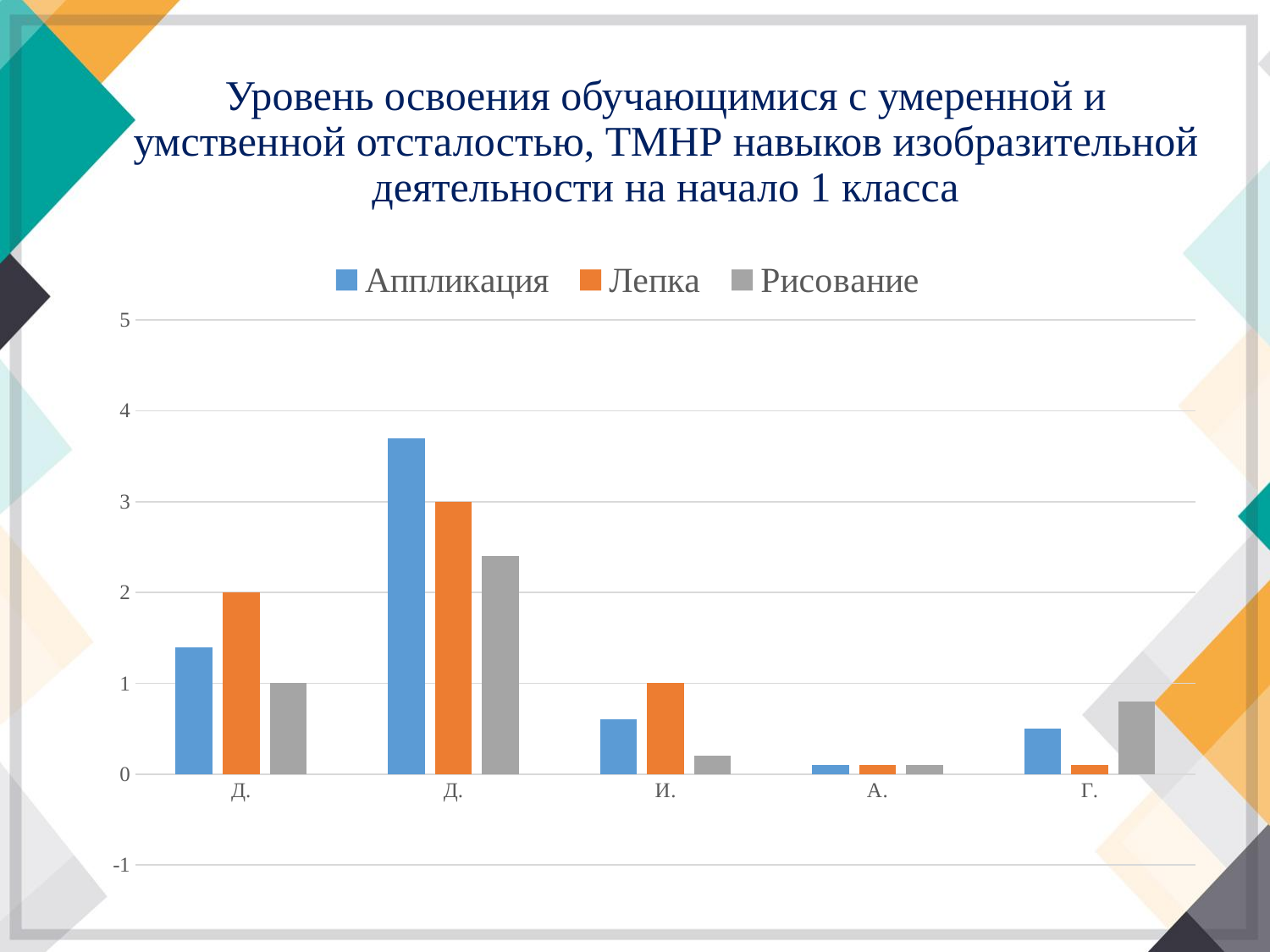
Is the value of Аппликация for the second category labelled Д. greater or less than 3? greater How many categories are shown along the x axis? 5 What is the value of Лепка for the first category labelled Д.? 2 Is the value of Рисование for the second category labelled Д. greater or less than 2? greater What is the value of Лепка for the category И.? 1 Which category has the highest value for Аппликация? the second Д. How many series does the legend list? 3 What is the value of Рисование for the first category labelled Д.? 1 What colour represents the series Лепка in the chart? orange What is the value of Лепка for the second category labelled Д.? 3 What type of chart is shown on the slide? bar chart For the first category labelled Д., which is larger: Аппликация or Лепка? Лепка